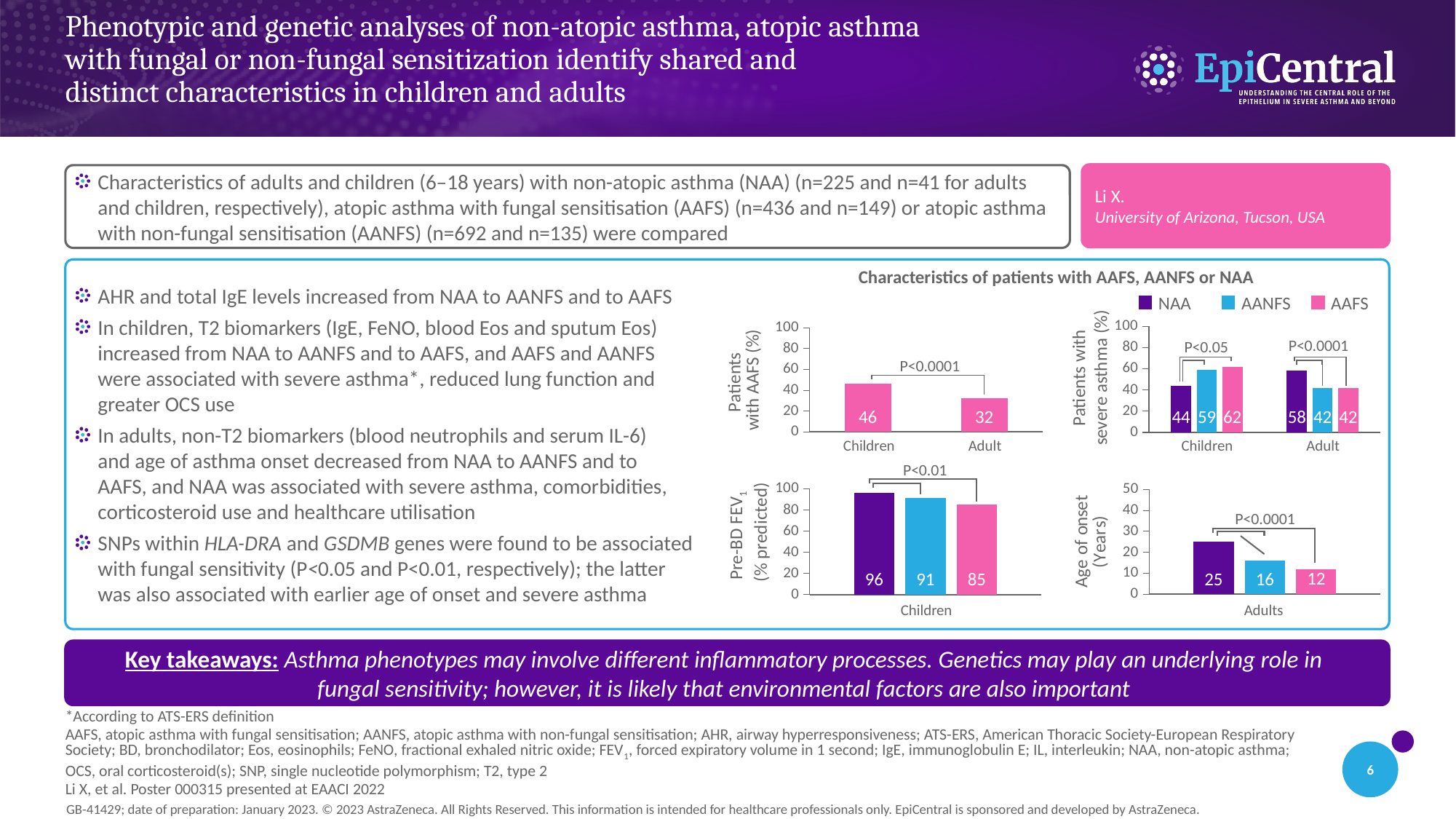
In the 'Age of onset (Years)' chart (bottom right), what is the difference between the NAA and AAFS values? 13 In the 'Patients with severe asthma (%)' chart (top right), which series has the highest value for Adult? NAA In the 'Patients with AAFS (%)' chart (top left), what is the value for Children? 46 In the 'Pre-BD FEV1 (% predicted)' chart (bottom left), which series has the highest value? NAA How many series does the legend list for the 'Characteristics of patients with AAFS, AANFS or NAA' charts? 3 What kind of chart is the 'Age of onset (Years)' chart (bottom right)? Bar chart In the 'Patients with severe asthma (%)' chart (top right), which series has the lowest value for Children? NAA In the 'Patients with severe asthma (%)' chart (top right), what is the value for AANFS in Children? 59 In the 'Pre-BD FEV1 (% predicted)' chart (bottom left), what is the value for AAFS? 85 In the 'Patients with severe asthma (%)' chart (top right), what is the difference between the NAA values for Adult and Children? 14 In the 'Patients with AAFS (%)' chart (top left), what is the difference between the Children and Adult values? 14 In the 'Age of onset (Years)' chart (bottom right), what is the value for AANFS? 16